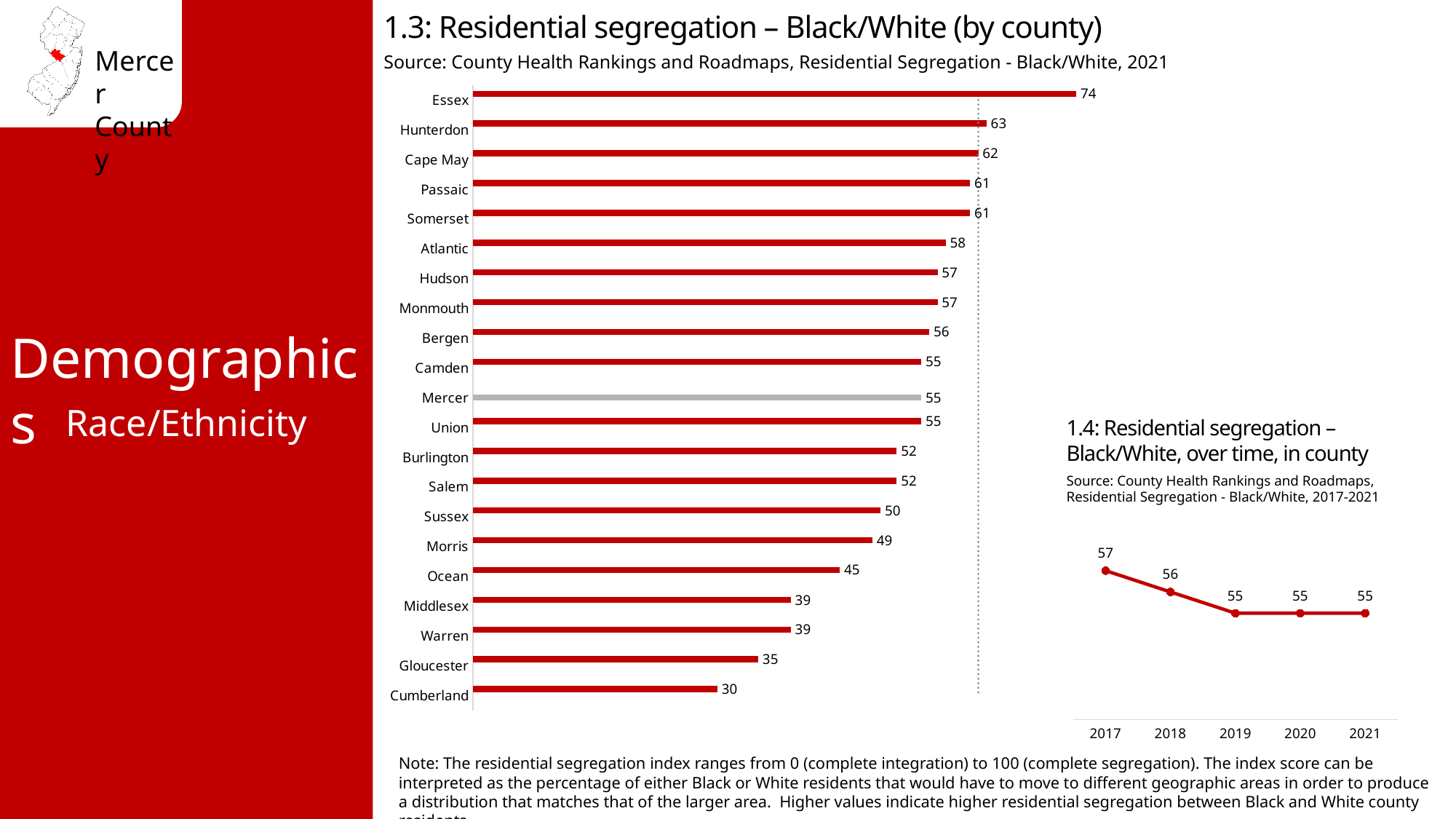
In chart 1.3 (Residential segregation – Black/White by county), what is the value for Mercer? 55 In chart 1.3 (Residential segregation – Black/White by county), how many counties are shown? 21 In chart 1.3 (Residential segregation – Black/White by county), which county has the highest value? Essex In chart 1.3 (Residential segregation – Black/White by county), which has a larger value, Ocean or Morris? Morris In chart 1.4 (Residential segregation – Black/White over time in county), what is the value for 2017? 57 In chart 1.3 (Residential segregation – Black/White by county), what is the value for Essex? 74 In chart 1.4 (Residential segregation – Black/White over time in county), do the values rise or fall from 2017 to 2021? Fall In chart 1.4 (Residential segregation – Black/White over time in county), how many years are plotted? 5 In chart 1.3 (Residential segregation – Black/White by county), which county has the lowest value? Cumberland What kind of chart is chart 1.3 (Residential segregation – Black/White by county)? Bar chart In chart 1.3 (Residential segregation – Black/White by county), what is the difference between Essex and Cumberland? 44 In chart 1.3 (Residential segregation – Black/White by county), which bar is shown in grey instead of red? Mercer